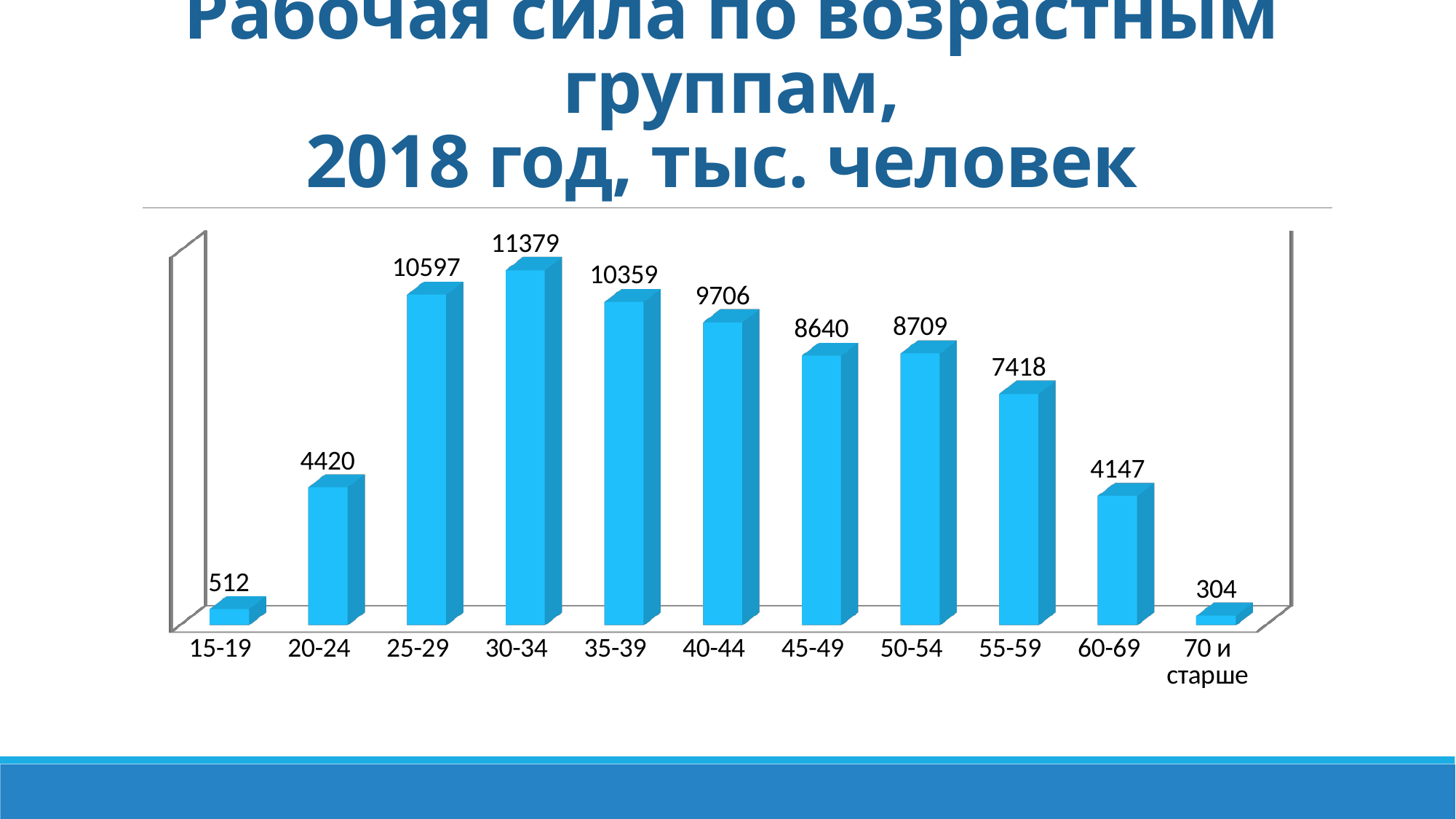
How many age groups are shown on the chart? 11 What is the value for the 70 и старше age group? 304 What kind of chart is shown on the slide? bar chart Which is larger, the value for 45-49 or the value for 50-54? 50-54 What is the difference between the values for 25-29 and 35-39? 238 Which age group has the lowest value? 70 и старше What is the value for the 30-34 age group? 11379 What is the value for the 20-24 age group? 4420 Which age group has the highest value? 30-34 Do the values rise or fall from the 40-44 group to the 70 и старше group? fall Which is larger, the value for 15-19 or the value for 70 и старше? 15-19 What is the difference between the values for 55-59 and 60-69? 3271